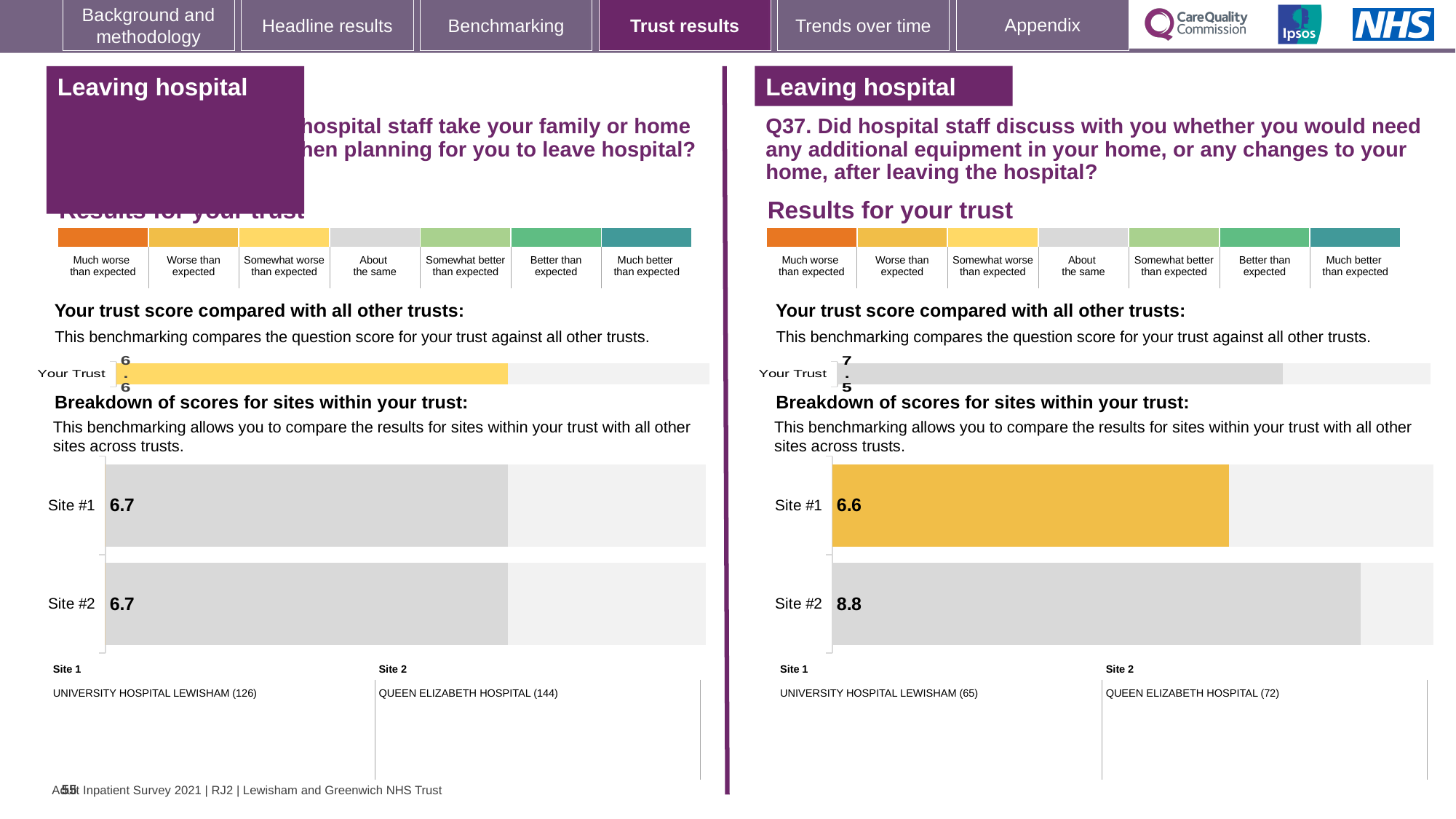
On the right-hand (Q37) site breakdown chart, what is the difference between the Site #2 and Site #1 scores? 2.2 What type of chart is used for the site breakdown on the right-hand (Q37) side of the slide? bar chart On the left-hand site breakdown chart, what is the score for Site #1? 6.7 On the right-hand (Q37) 'Your trust score compared with all other trusts' chart, what is the score shown for Your Trust? 7.5 On the left-hand 'Your trust score compared with all other trusts' chart, what is the score shown for Your Trust? 6.6 On the right-hand (Q37) site breakdown chart, which site's bar is coloured yellow? Site #1 On the right-hand (Q37) site breakdown chart, is the score for Site #1 larger or smaller than the score for Site #2? smaller How many sites are shown on the left-hand site breakdown chart? 2 On the right-hand (Q37) site breakdown chart, what is the score for Site #2? 8.8 On the right-hand (Q37) site breakdown chart, which site has the higher score? Site #2 On the right-hand (Q37) site breakdown chart, what is the score for Site #1? 6.6 On the left-hand site breakdown chart, what is the score for Site #2? 6.7